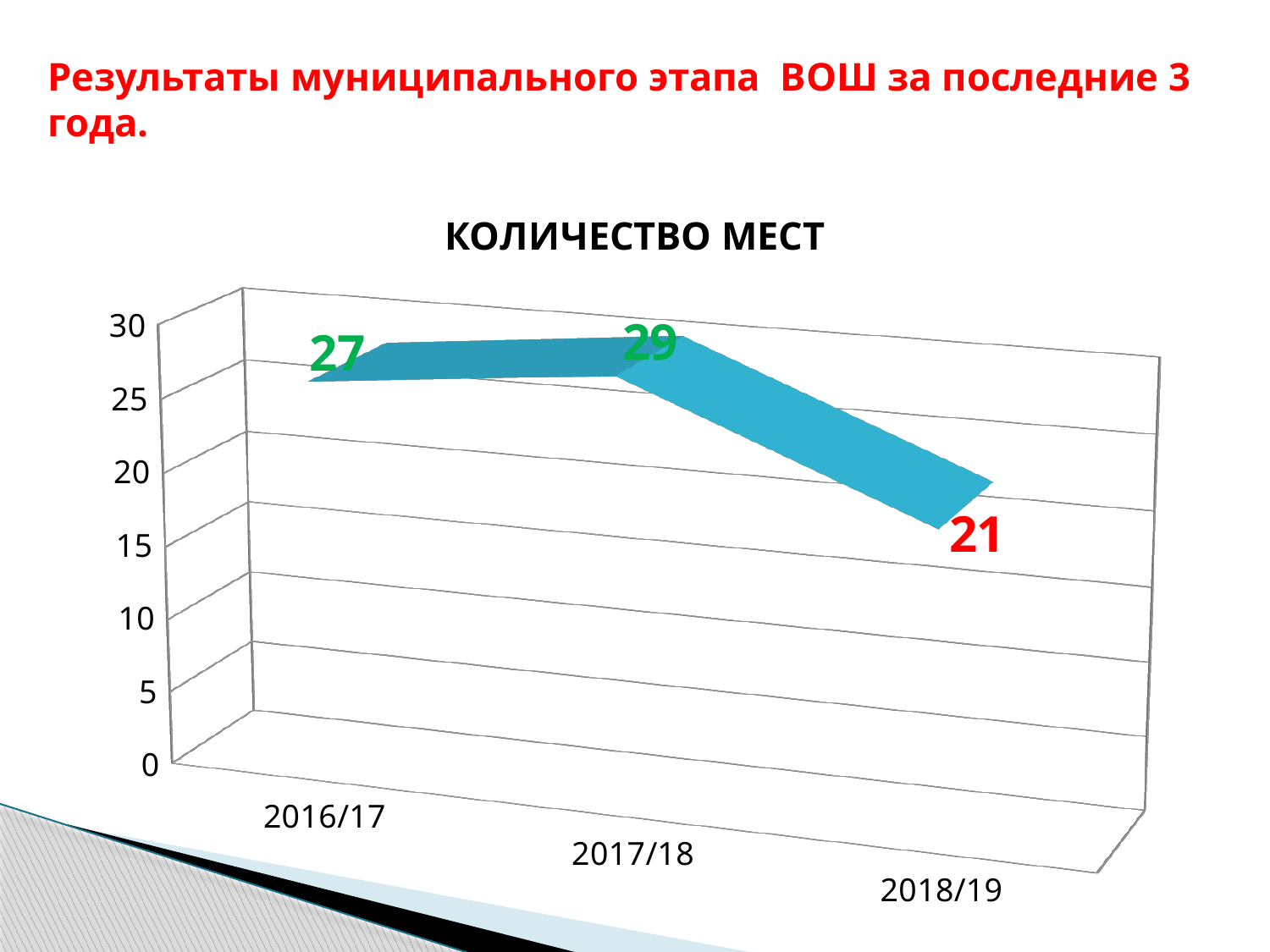
Which year has the highest value? 2017/18 Which year has the lowest value? 2018/19 How many years are shown on the x axis? 3 What is the value for 2017/18? 29 Is the value for 2018/19 greater or less than 25? less What is the difference between the values for 2017/18 and 2016/17? 2 What is the title of the chart? КОЛИЧЕСТВО МЕСТ What is the difference between the values for 2017/18 and 2018/19? 8 What kind of chart is this? line chart What is the value for 2018/19? 21 Which is larger, the value for 2016/17 or the value for 2018/19? 2016/17 What is the value for 2016/17? 27